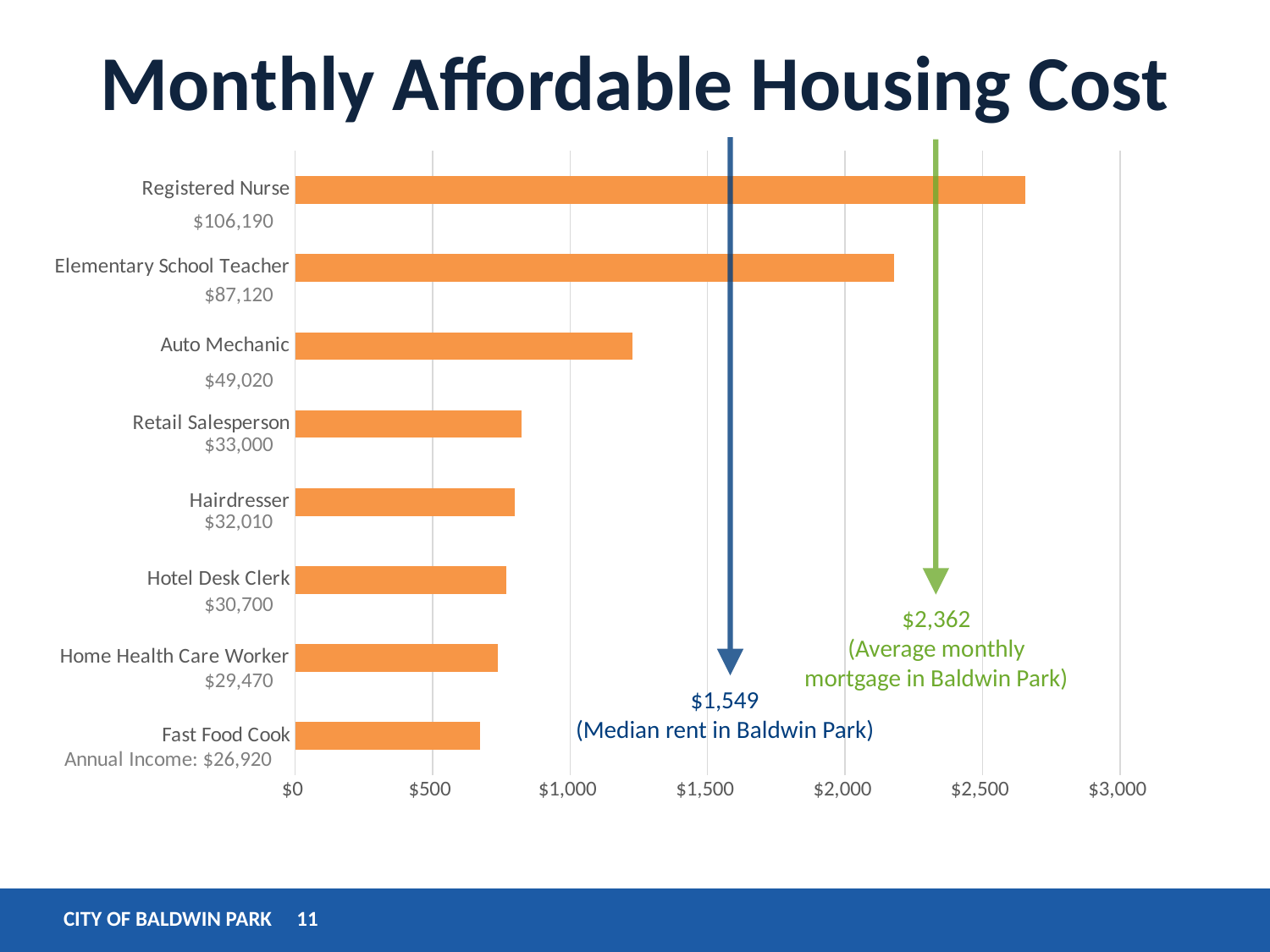
How many occupations are plotted in the chart? 8 Is the monthly affordable housing cost for Retail Salesperson greater or less than $1,000? less Is the monthly affordable housing cost for Registered Nurse greater or less than $2,500? greater Which occupation has the highest monthly affordable housing cost? Registered Nurse Do the bar values increase or decrease going from the top occupation to the bottom occupation? decrease What is the median rent in Baldwin Park marked on the chart? $1,549 What kind of chart is shown on the slide? bar chart Which occupation has the lowest monthly affordable housing cost? Fast Food Cook Which has a higher monthly affordable housing cost, Elementary School Teacher or Auto Mechanic? Elementary School Teacher Is the monthly affordable housing cost for Auto Mechanic greater or less than $1,000? greater What is the average monthly mortgage in Baldwin Park marked on the chart? $2,362